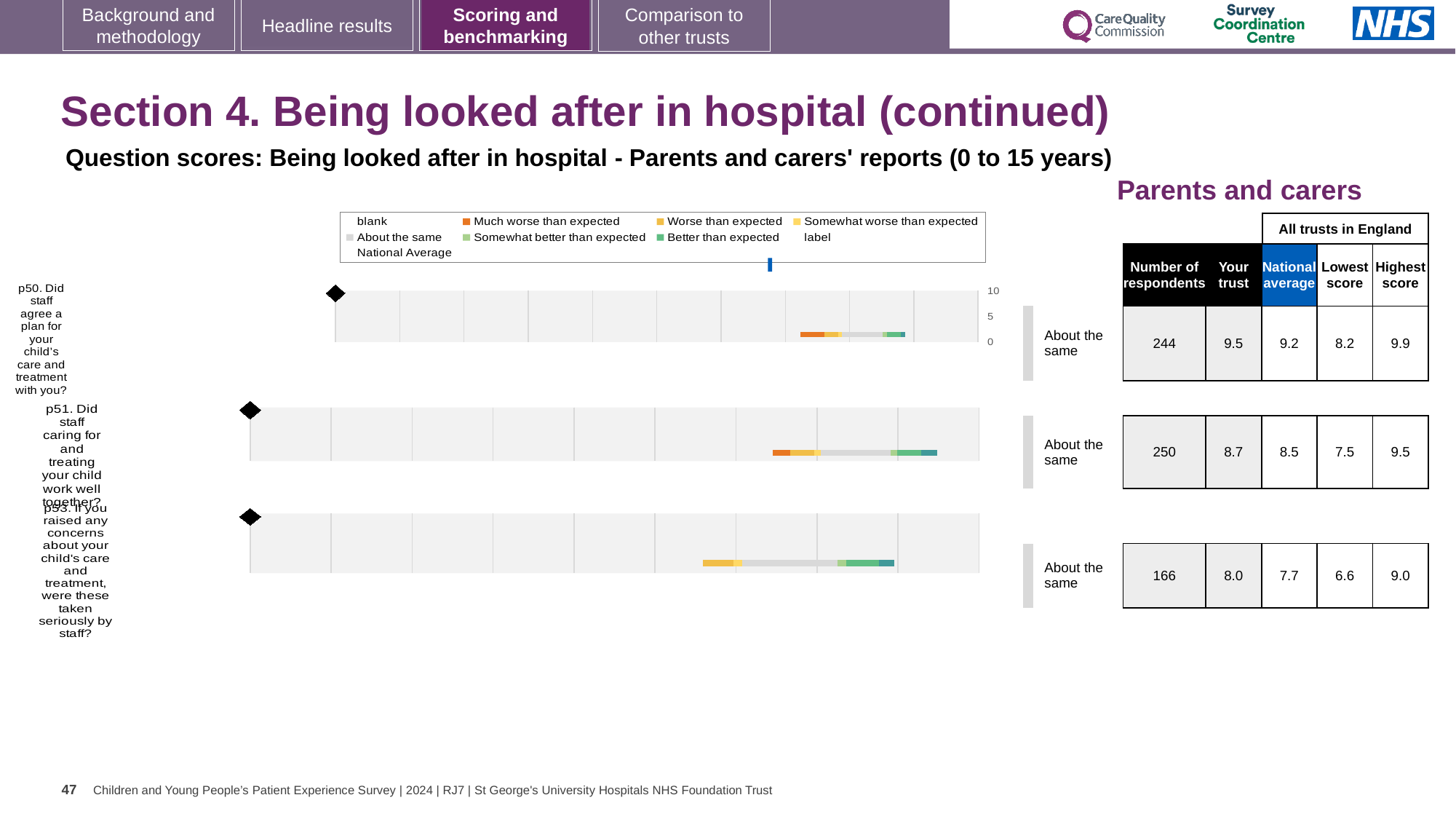
How many questions (p50, p51, p53) have a score chart on this slide? 3 For p51, which is larger: the 'Your trust' score or the national average? Your trust What is the highest value shown on the score axis of the p50 chart? 10 Which question has the highest 'Your trust' score on this slide? p50 How many respondents are shown for p53 (If you raised any concerns about your child's care and treatment, were these taken seriously by staff?)? 166 Which question has the lowest national average score on this slide? p53 What kind of chart is used to show the question scores on this slide? bar chart What is the highest score among all trusts in England for p53? 9.0 What is the 'Your trust' score for p50 (Did staff agree a plan for your child's care and treatment with you?)? 9.5 For p50, what is the difference between the 'Your trust' score and the national average? 0.3 What is the national average score for p51 (Did staff caring for and treating your child work well together?)? 8.5 What benchmark category is shown for p51 (Did staff caring for and treating your child work well together?)? About the same